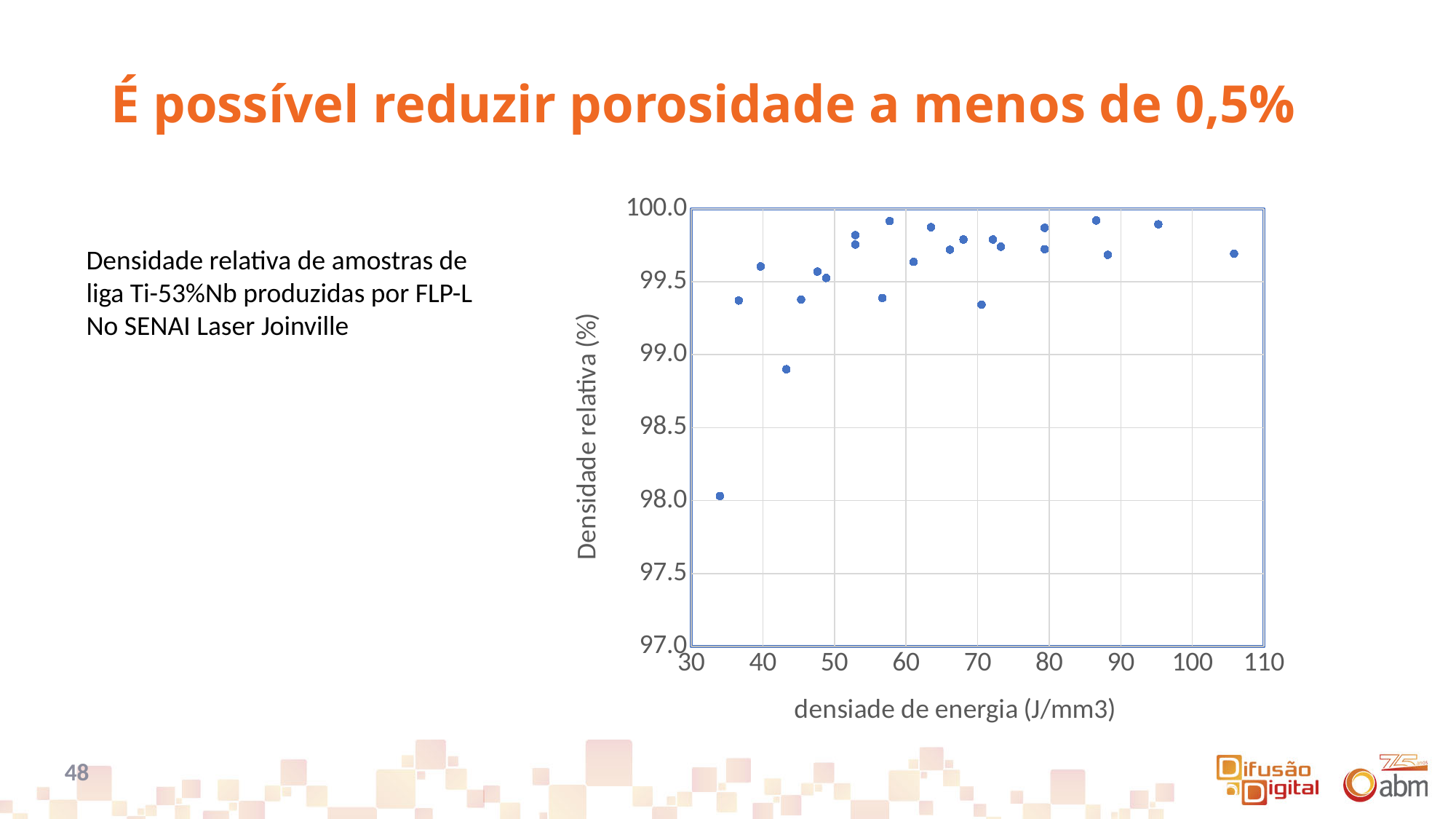
What is the lowest value shown on the x axis of the chart? 30 Do the relative density values generally rise or fall as energy density increases along the x axis? rise What kind of chart is shown on the slide? Scatter chart Is the relative density of the point at about 43 J/mm3 greater or less than 99.5? less Is the highest plotted relative density value greater or less than 99.5? greater What is the title of the y axis of the chart? Densidade relativa (%) Is the lowest plotted relative density value greater or less than 98.5? less What is the lowest value shown on the y axis of the chart? 97.0 What is the title of the x axis of the chart? densiade de energia (J/mm3) What is the highest value shown on the y axis of the chart? 100.0 What is the highest value shown on the x axis of the chart? 110